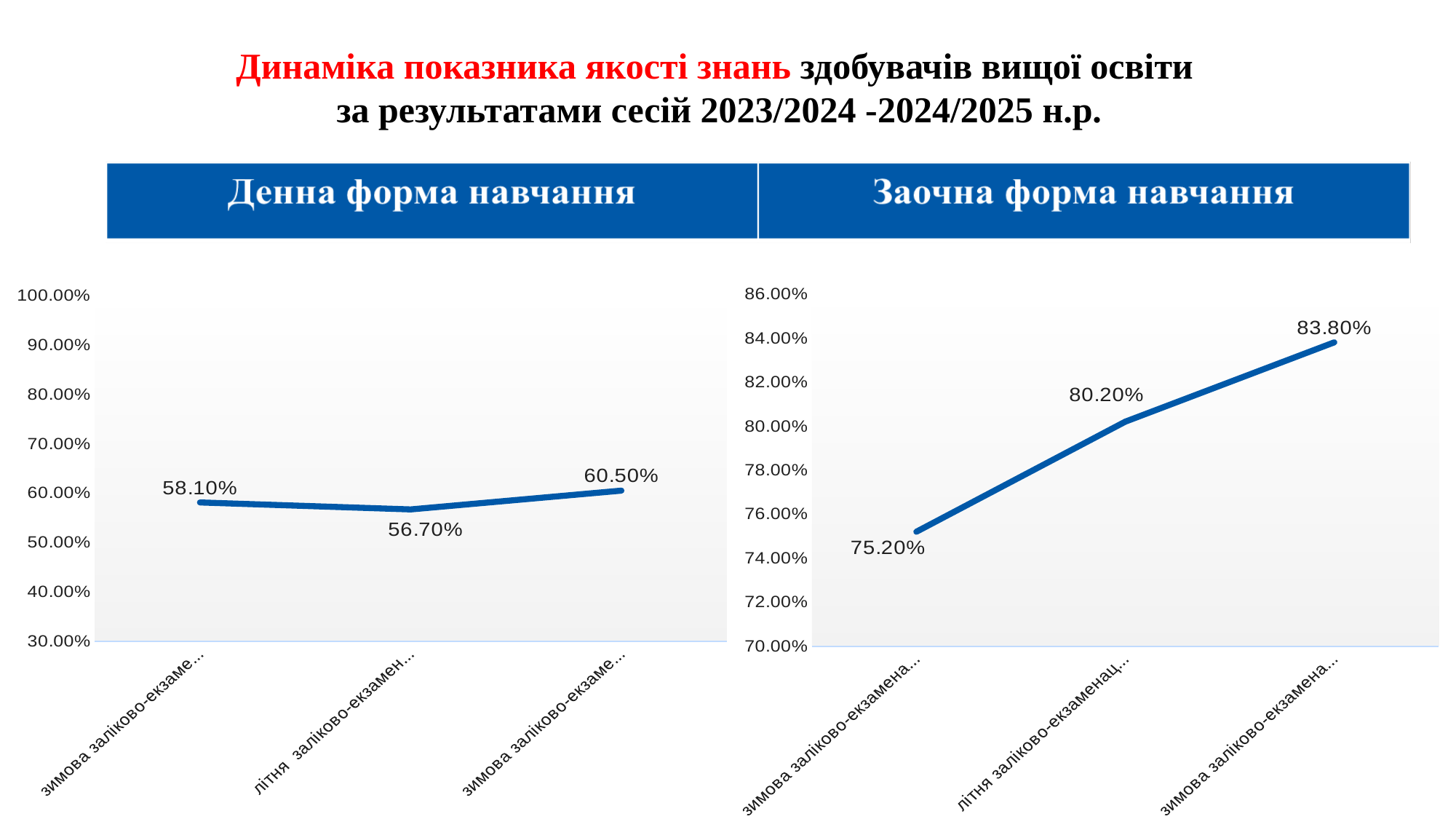
In the 'Денна форма навчання' chart, what is the value at the second point (літня заліково-екзаменаційна сесія)? 56.70% How many data points are plotted in the 'Денна форма навчання' chart? 3 In the 'Заочна форма навчання' chart, what is the value at the middle (second) point? 80.20% What type of chart is used in the 'Заочна форма навчання' panel? Line chart In the 'Денна форма навчання' chart, which is larger: the value at the first point or the value at the second point? The first point (58.10%) In the 'Денна форма навчання' chart, is the value at the second point greater or less than 60.00%? less In the 'Денна форма навчання' chart, what is the difference between the third point and the second point? 3.80% In the 'Заочна форма навчання' chart, what is the value at the last (third) point? 83.80% In the 'Денна форма навчання' chart, which point has the highest value? The third (last) point, 60.50% In the 'Заочна форма навчання' chart, what is the difference between the last point and the first point? 8.60% In the 'Заочна форма навчання' chart, do the values rise or fall from left to right? Rise In the 'Заочна форма навчання' chart, which point has the lowest value? The first point, 75.20%